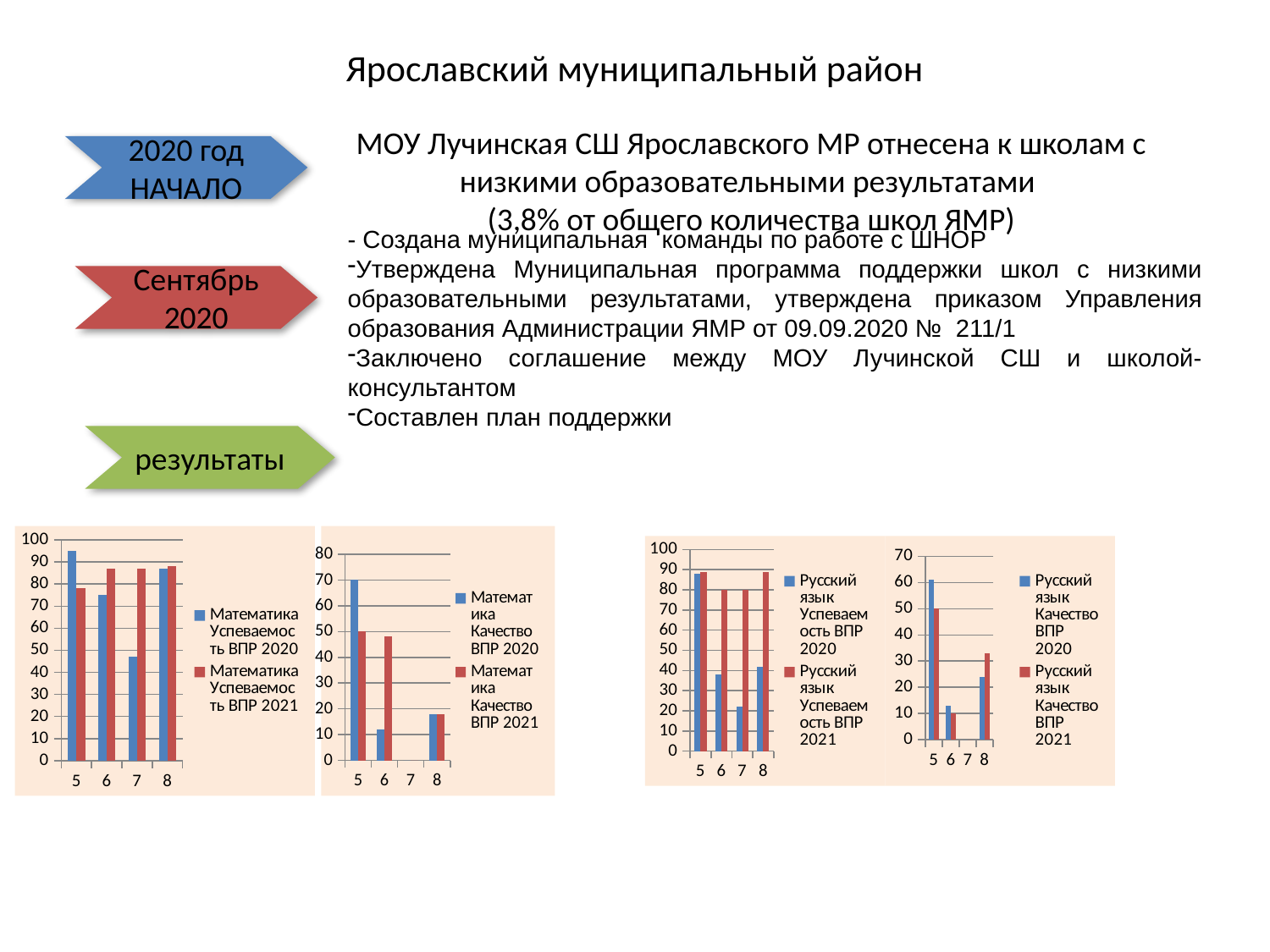
In the leftmost chart, which category has the highest value for Математика Успеваемость ВПР 2020? 5 What kind of chart is the leftmost chart on the slide? bar chart In the third chart from the left, which category has the lowest value for Русский язык Успеваемость ВПР 2020? 7 In the rightmost chart, is the value for category 5 in Русский язык Качество ВПР 2020 greater or less than 50? greater In the leftmost chart, is the value for category 7 in Математика Успеваемость ВПР 2020 greater or less than 50? less In the second chart from the left, is the value for category 5 in Математика Качество ВПР 2020 greater or less than 60? greater In the second chart from the left, which category has the highest value for Математика Качество ВПР 2020? 5 How many categories are shown on the x axis of the leftmost chart? 4 In the third chart from the left, for category 6, which series is larger: Русский язык Успеваемость ВПР 2020 or Русский язык Успеваемость ВПР 2021? Русский язык Успеваемость ВПР 2021 In the leftmost chart, which category has the lowest value for Математика Успеваемость ВПР 2020? 7 What colour are the bars for the 2021 series in the rightmost chart? red How many series does the legend of the leftmost chart list? 2